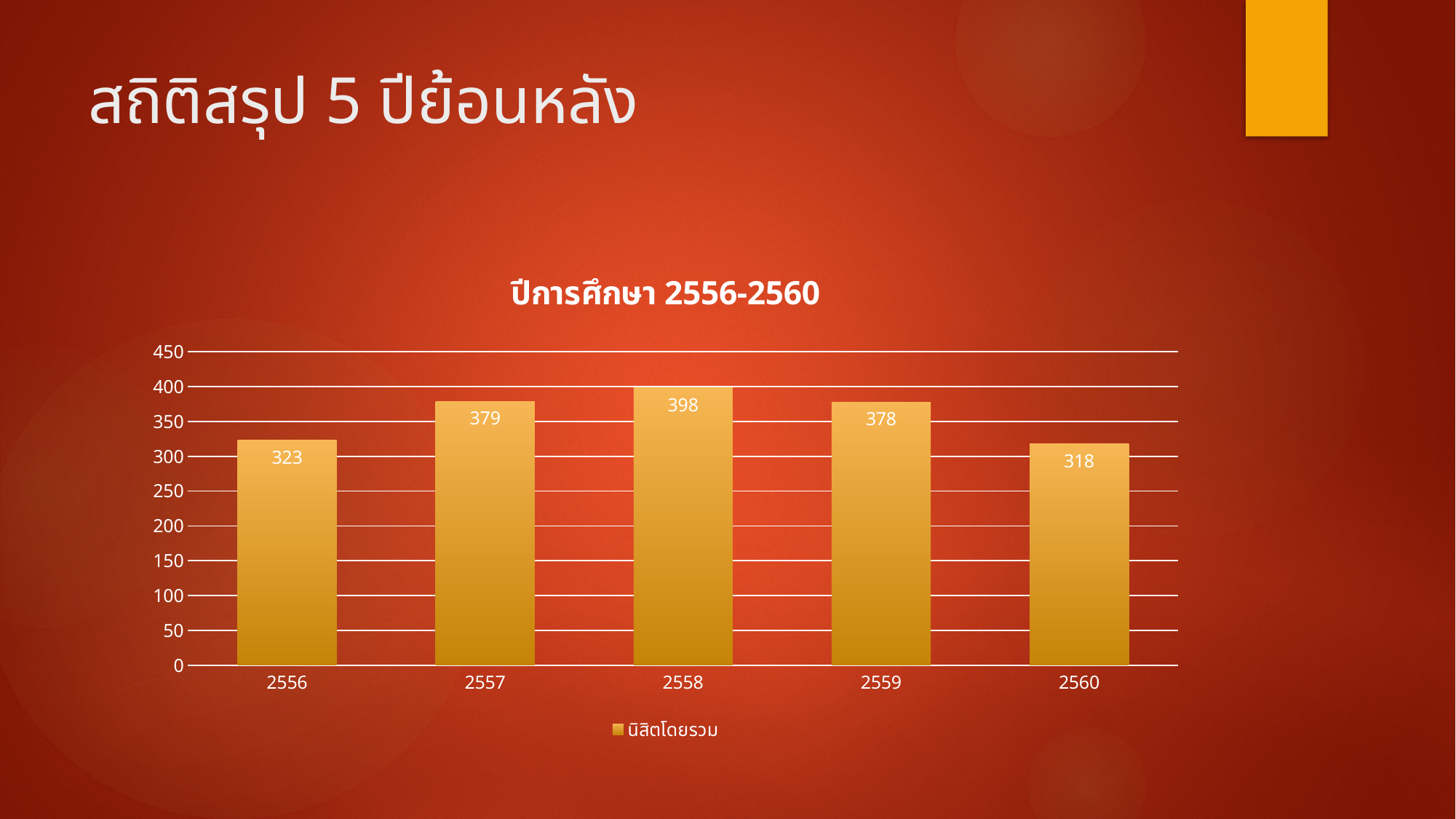
Is the value for 2559 greater or less than 350? greater Which is larger, the value for 2557 or the value for 2560? 2557 What is the difference between the values for 2558 and 2556? 75 What is the difference between the values for 2557 and 2559? 1 How many years are shown on the x axis? 5 What is the value for 2558? 398 What is the value for 2560? 318 What is the value for 2556? 323 What is the title of the chart? ปีการศึกษา 2556-2560 Which year has the lowest value? 2560 What kind of chart is shown on the slide? bar chart Which year has the highest value? 2558